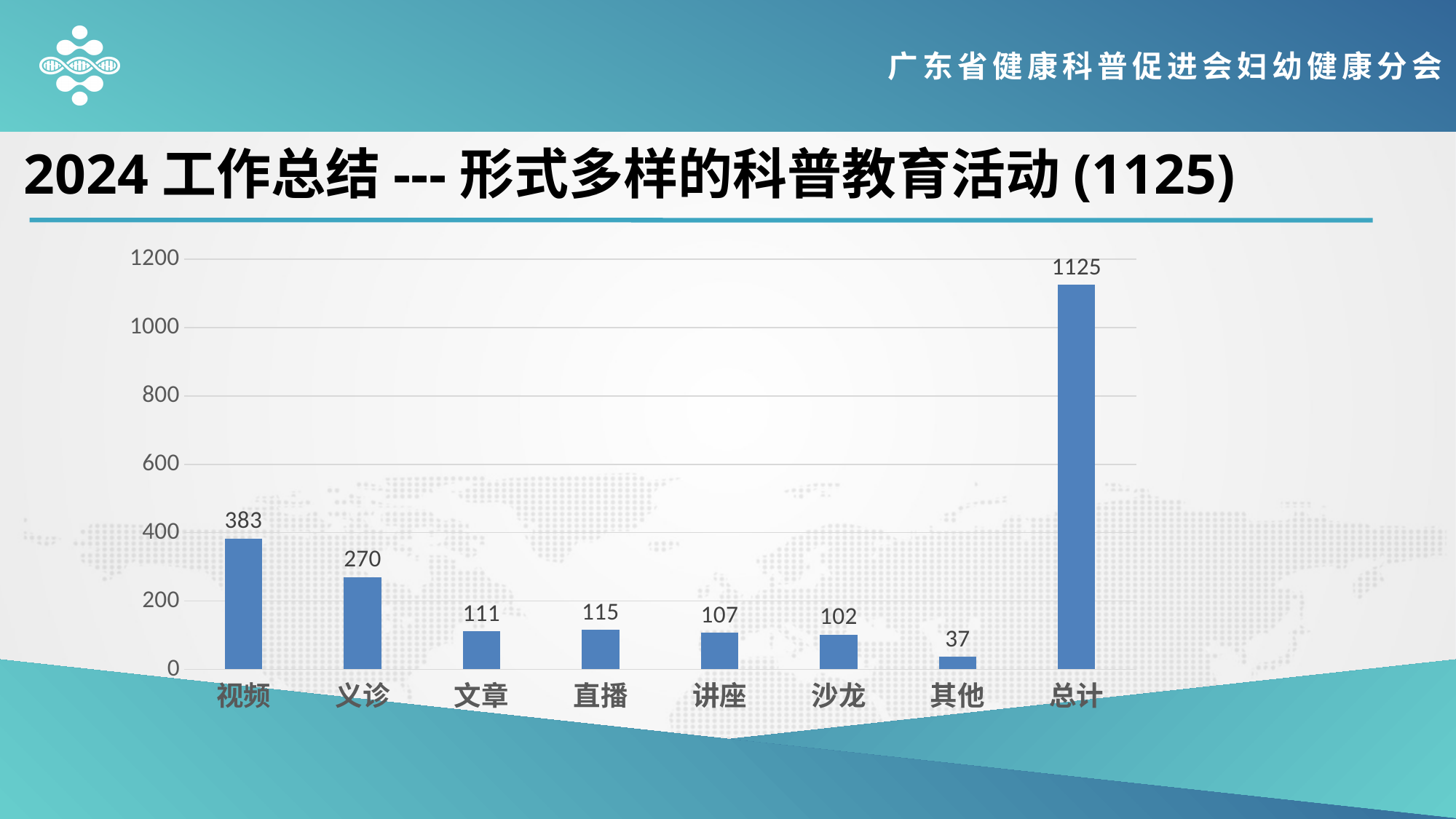
What is the value for 其他? 37 What is the value for 总计? 1125 What kind of chart is shown on the slide? bar chart What is the value for 义诊? 270 What is the difference between the values for 视频 and 义诊? 113 Excluding 总计, which category has the highest value? 视频 Which category has the lowest value? 其他 What is the difference between the values for 文章 and 其他? 74 How many categories are shown on the x axis? 8 Is the value for 沙龙 greater or less than 200? less Which is larger, the value for 直播 or the value for 讲座? 直播 What is the value for 视频? 383